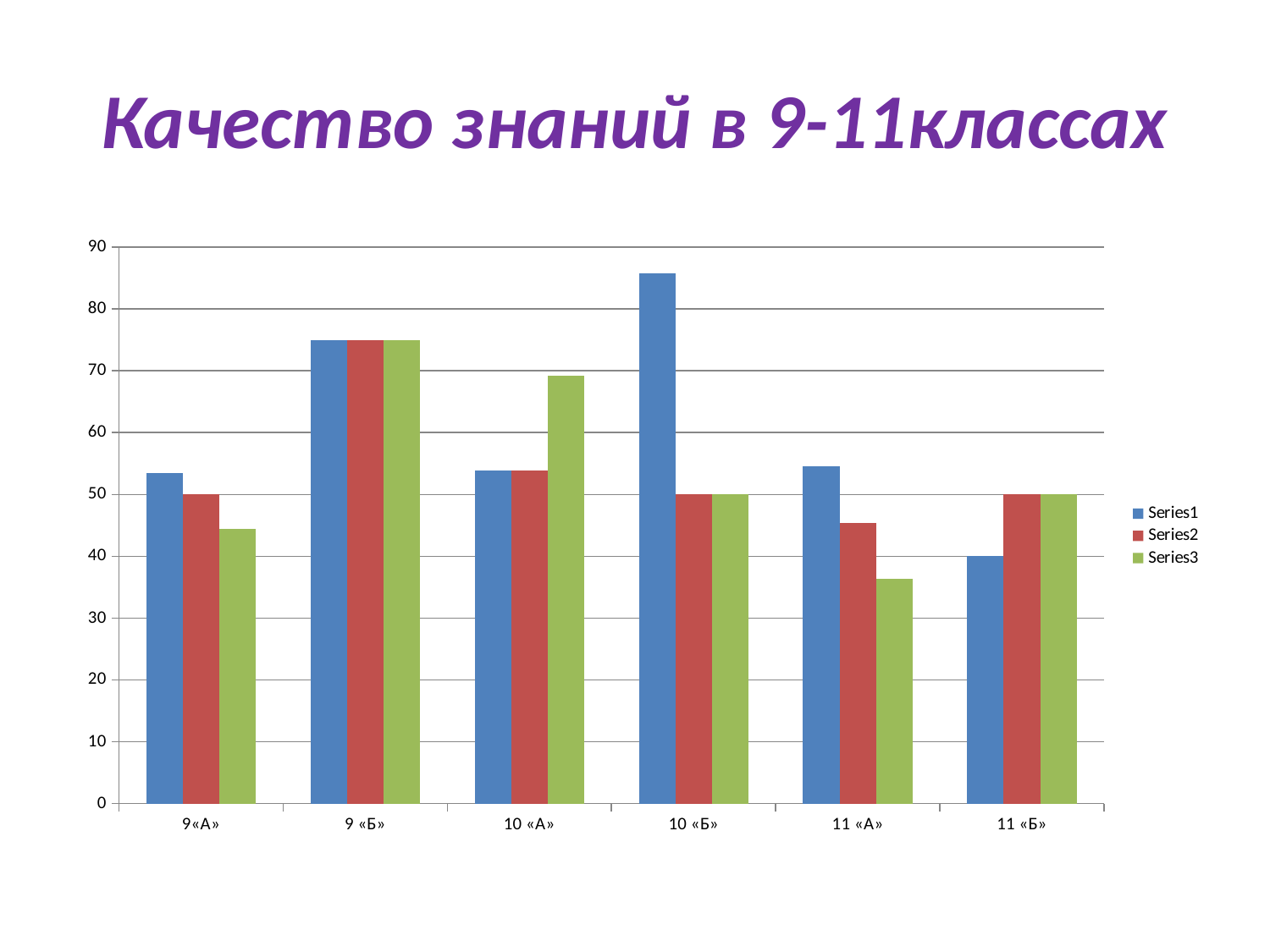
What kind of chart is shown on the slide? bar chart How many series does the legend list? 3 Which category has the highest Series1 value? 10 «Б» Which category has the lowest Series3 value? 11 «А» Which category has the lowest Series1 value? 11 «Б» Is the Series1 value for 10 «Б» greater or less than 80? greater How many categories are shown on the x axis? 6 Is the Series3 value for 11 «А» greater or less than 40? less What is the title of the chart on the slide? Качество знаний в 9-11классах Which is larger, the Series3 value for 10 «А» or the Series3 value for 10 «Б»? 10 «А» What is the Series2 value for 9«А»? 50 What is the Series1 value for 11 «Б»? 40